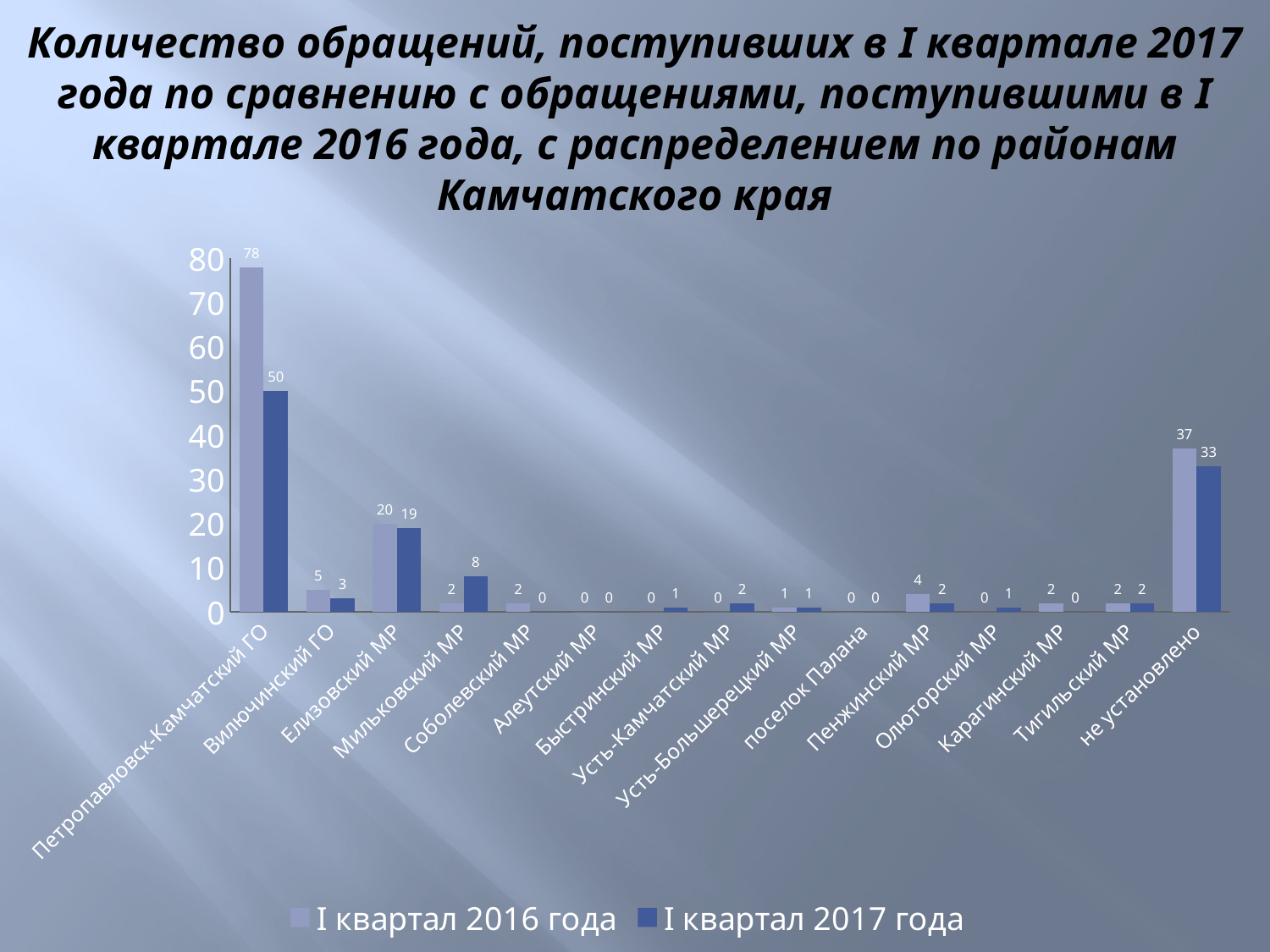
What is the difference between the I квартал 2016 года and I квартал 2017 года values for Петропавловск-Камчатский ГО? 28 What is the difference between the I квартал 2016 года and I квартал 2017 года values for не установлено? 4 For Мильковский МР, which series has the larger value: I квартал 2016 года or I квартал 2017 года? I квартал 2017 года How many categories are shown on the x axis? 15 What is the value for не установлено in the series I квартал 2016 года? 37 What is the value for Елизовский МР in the series I квартал 2017 года? 19 What is the value for Мильковский МР in the series I квартал 2017 года? 8 Which category has the highest value in the series I квартал 2017 года? Петропавловск-Камчатский ГО What is the value for Петропавловск-Камчатский ГО in the series I квартал 2016 года? 78 How many series does the legend list? 2 What is the value for Петропавловск-Камчатский ГО in the series I квартал 2017 года? 50 What kind of chart is shown on the slide? Bar chart